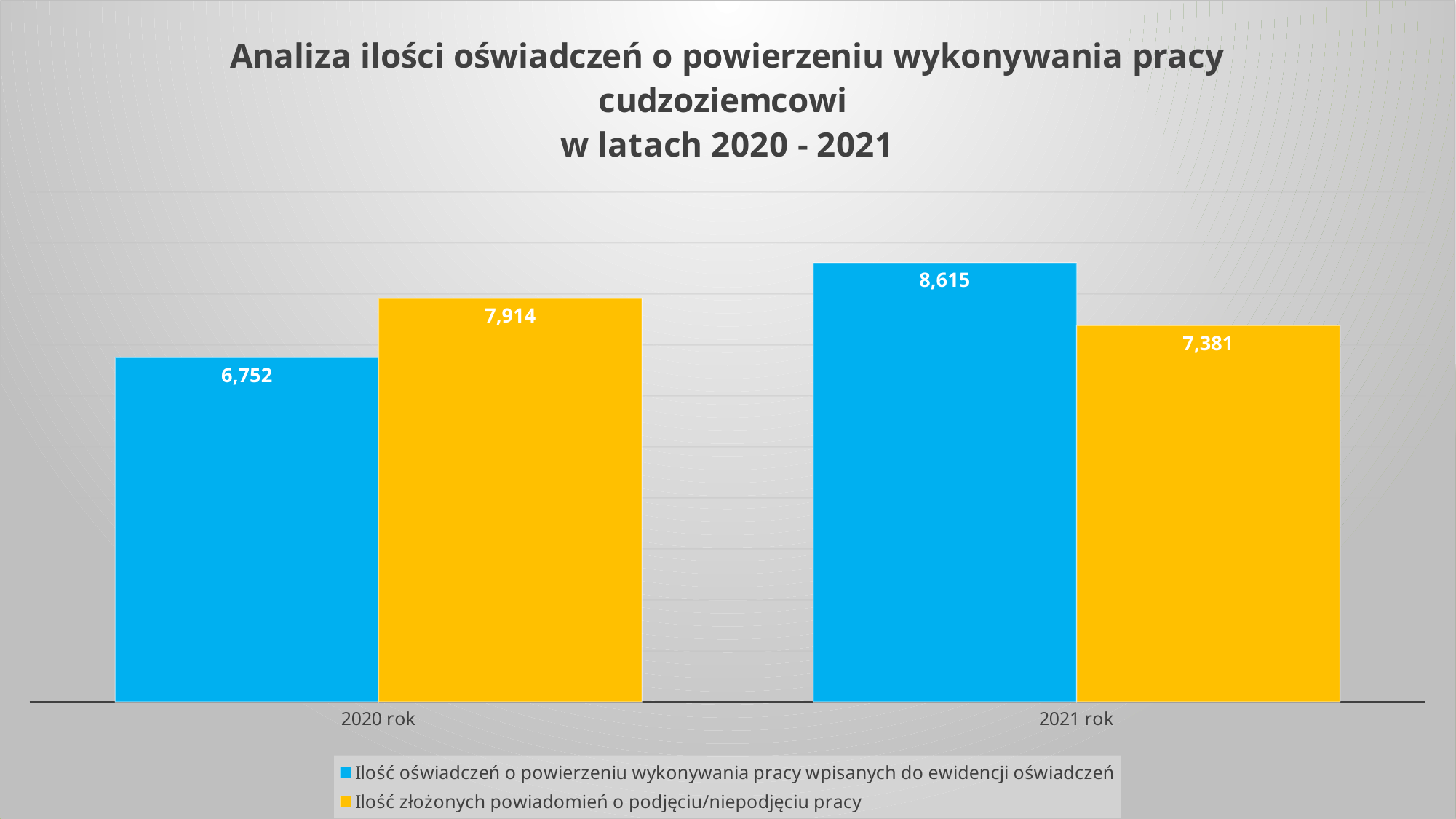
What is the value of 'Ilość oświadczeń o powierzeniu wykonywania pracy wpisanych do ewidencji oświadczeń' for 2021 rok? 8,615 What is the difference between the 2020 rok and 2021 rok values for 'Ilość złożonych powiadomień o podjęciu/niepodjęciu pracy'? 533 What kind of chart is shown on the slide? Bar chart In 2020 rok, which series has the larger value? Ilość złożonych powiadomień o podjęciu/niepodjęciu pracy What is the value of 'Ilość oświadczeń o powierzeniu wykonywania pracy wpisanych do ewidencji oświadczeń' for 2020 rok? 6,752 How many categories are shown on the x axis? 2 What is the value of 'Ilość złożonych powiadomień o podjęciu/niepodjęciu pracy' for 2021 rok? 7,381 Which bar has the lowest value on the chart? Ilość oświadczeń o powierzeniu wykonywania pracy wpisanych do ewidencji oświadczeń, 2020 rok How many series does the legend list? 2 What is the value of 'Ilość złożonych powiadomień o podjęciu/niepodjęciu pracy' for 2020 rok? 7,914 What is the difference between the 2021 rok and 2020 rok values for 'Ilość oświadczeń o powierzeniu wykonywania pracy wpisanych do ewidencji oświadczeń'? 1,863 Which bar has the highest value on the chart? Ilość oświadczeń o powierzeniu wykonywania pracy wpisanych do ewidencji oświadczeń, 2021 rok